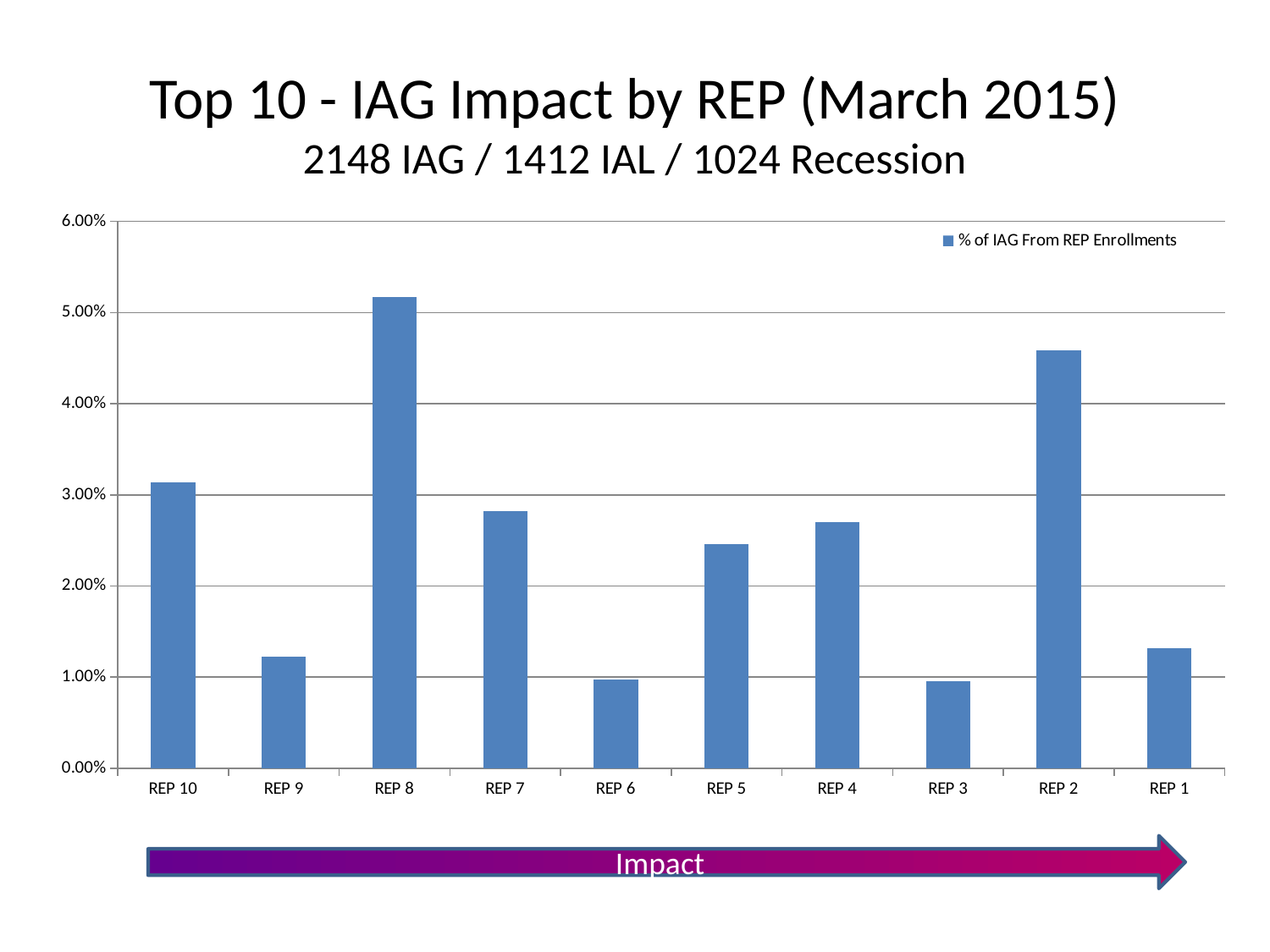
Which has a larger value, REP 2 or REP 10? REP 2 Is the value for REP 2 greater or less than 5.00%? less Which has a larger value, REP 7 or REP 9? REP 7 How many series does the legend list? 1 Is the value for REP 7 greater or less than 3.00%? less Which REP has the highest % of IAG From REP Enrollments? REP 8 Is the value for REP 5 greater or less than 2.00%? greater What is the series name shown in the legend? % of IAG From REP Enrollments What type of chart is shown on the slide? bar chart How many REP categories are plotted on the x axis? 10